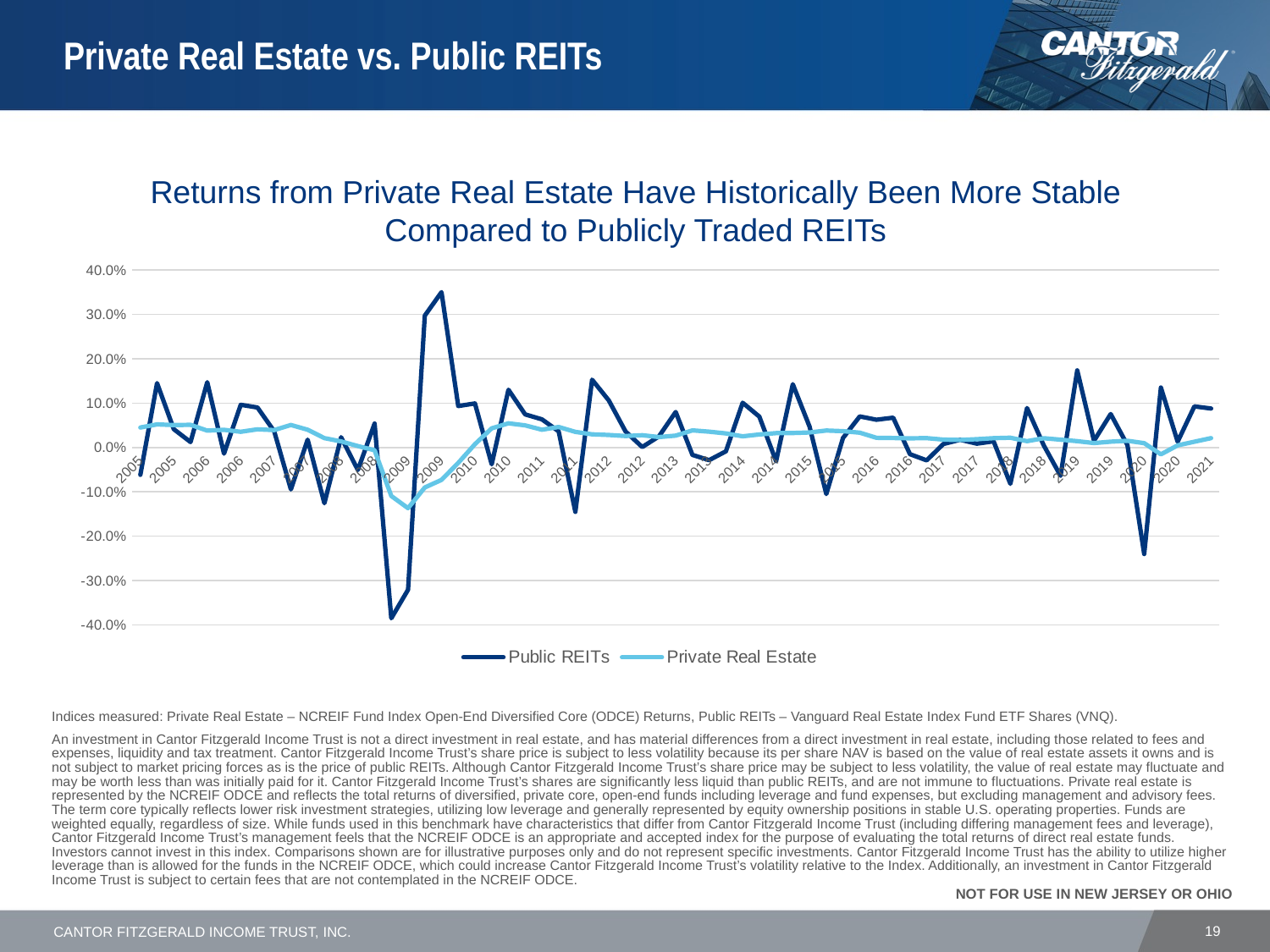
Is the peak value of the Public REITs line around 2009 greater or less than 30.0%? greater What kind of chart is shown on the slide? Line chart Is the Public REITs dip in 2020 greater or less than -20.0%? less Is the lowest value of the Public REITs line around 2008-2009 greater or less than -30.0%? less How many series does the chart's legend list? 2 Which series reaches the lowest value anywhere on the chart? Public REITs Which series reaches the highest value anywhere on the chart? Public REITs What are the two series named in the chart's legend? Public REITs and Private Real Estate What is the title shown above the chart? Returns from Private Real Estate Have Historically Been More Stable Compared to Publicly Traded REITs What is the highest value shown on the chart's vertical axis? 40.0%